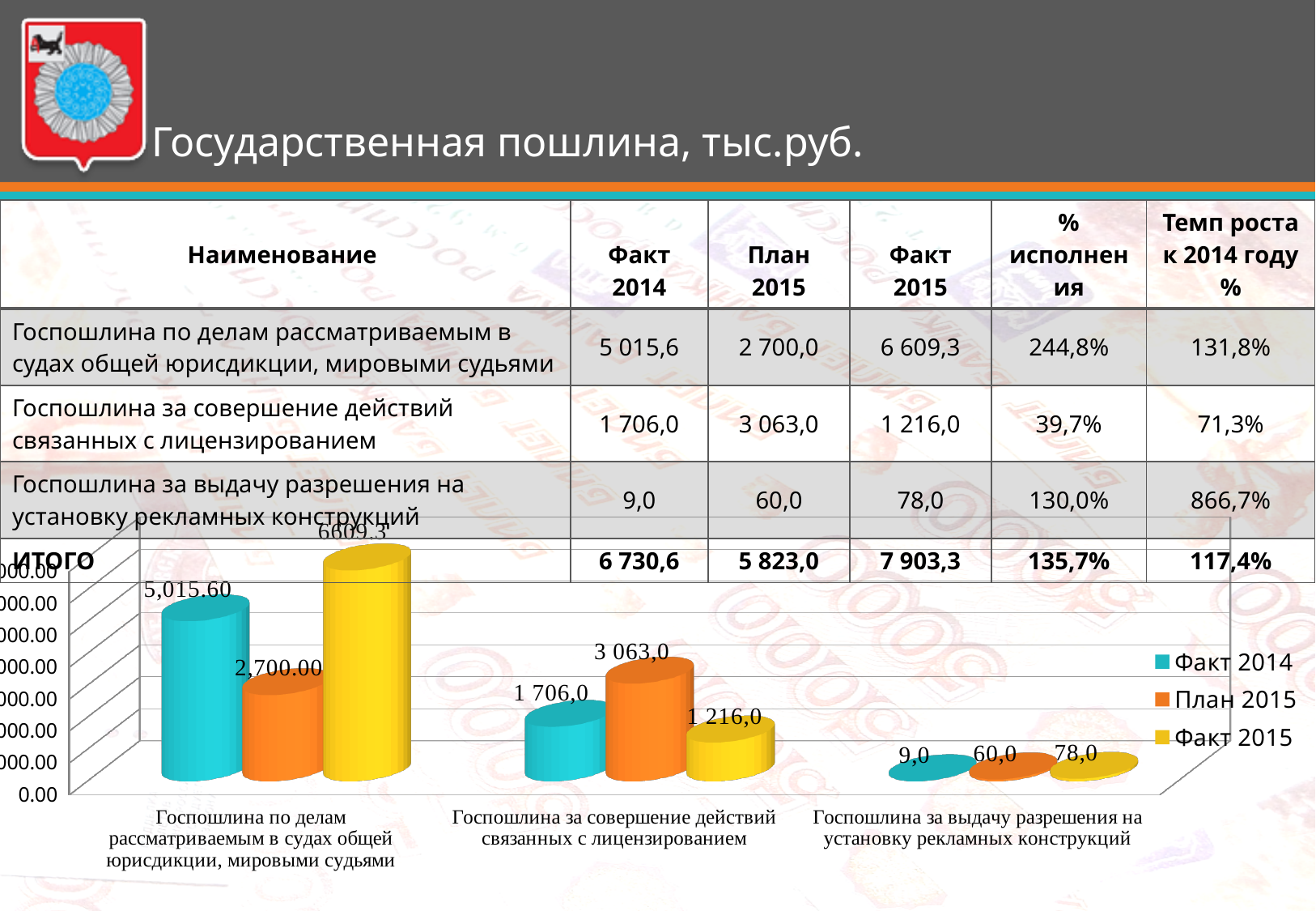
In the chart, which is larger for Госпошлина за выдачу разрешения на установку рекламных конструкций: План 2015 or Факт 2015? Факт 2015 In the chart, what is the Факт 2014 value for Госпошлина по делам рассматриваемым в судах общей юрисдикции, мировыми судьями? 5,015.60 In the chart, which series has the highest value for Госпошлина по делам рассматриваемым в судах общей юрисдикции, мировыми судьями? Факт 2015 In the chart, what is the Факт 2014 value for Госпошлина за совершение действий связанных с лицензированием? 1 706,0 How many series does the chart legend list? 3 Which legend entry is shown in orange? План 2015 In the chart, what is the Факт 2015 value for Госпошлина за выдачу разрешения на установку рекламных конструкций? 78,0 In the chart, what is the difference between the План 2015 and Факт 2015 values for Госпошлина за совершение действий связанных с лицензированием? 1 847,0 In the chart, which category has the lowest Факт 2014 value? Госпошлина за выдачу разрешения на установку рекламных конструкций In the chart, what is the План 2015 value for Госпошлина за совершение действий связанных с лицензированием? 3 063,0 How many categories are shown on the chart's x axis? 3 What kind of chart is shown on the slide? bar chart